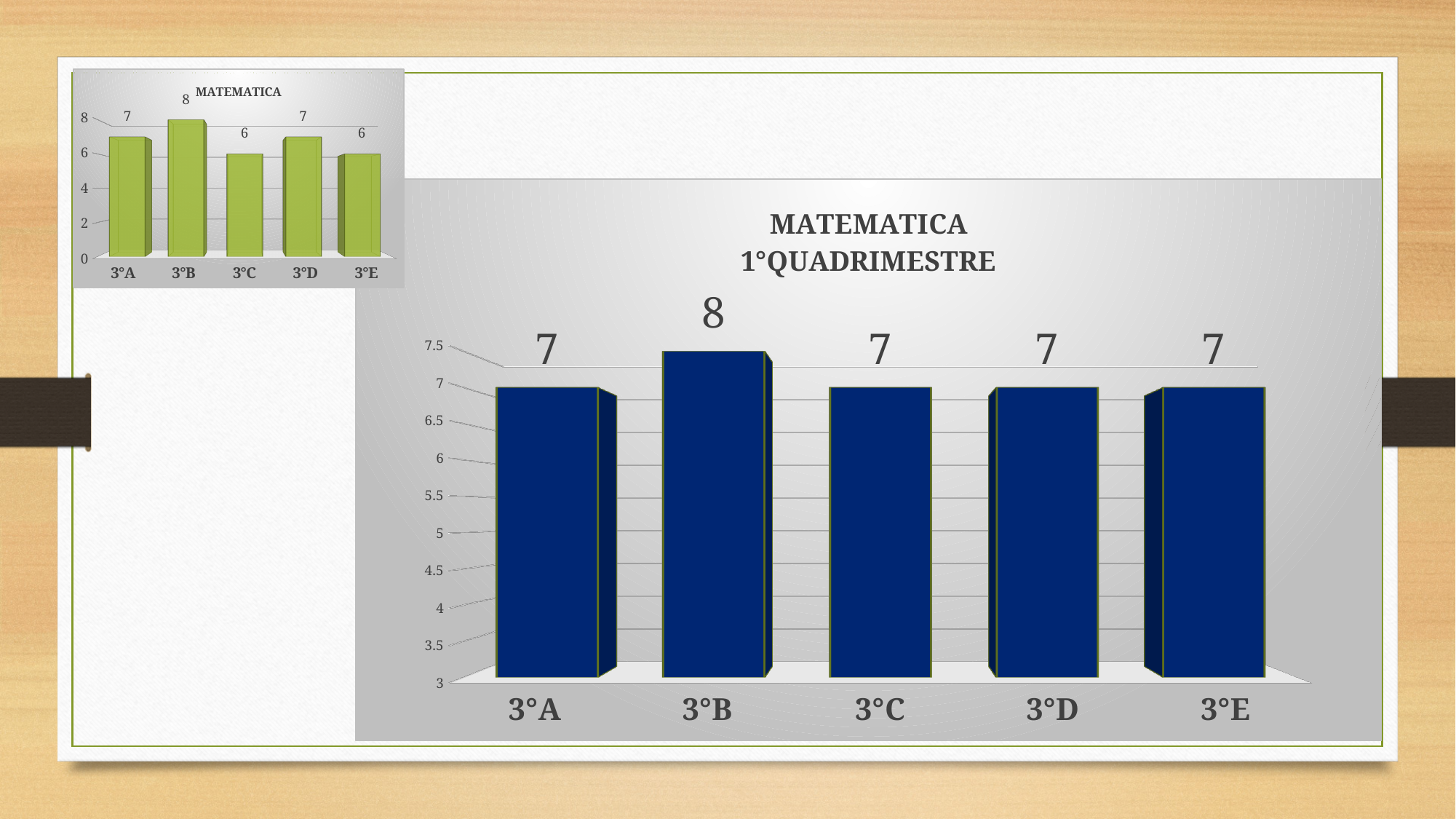
What kind of chart is the MATEMATICA 1°QUADRIMESTRE chart? Bar chart In the small MATEMATICA chart at the top left, what is the difference between the values for 3°B and 3°E? 2 In the MATEMATICA 1°QUADRIMESTRE chart, what is the value for 3°B? 8 In the small MATEMATICA chart at the top left, what is the value for 3°E? 6 In the MATEMATICA 1°QUADRIMESTRE chart, which class has the highest value? 3°B In the MATEMATICA 1°QUADRIMESTRE chart, what is the value for 3°D? 7 In the MATEMATICA 1°QUADRIMESTRE chart, how many classes are shown on the x axis? 5 In the MATEMATICA 1°QUADRIMESTRE chart, what is the difference between the values for 3°B and 3°A? 1 In the small MATEMATICA chart at the top left, what is the value for 3°C? 6 In the small MATEMATICA chart at the top left, which class has the highest value? 3°B What colour are the bars in the MATEMATICA 1°QUADRIMESTRE chart? Dark blue In the small MATEMATICA chart at the top left, which is larger, the value for 3°A or the value for 3°C? 3°A